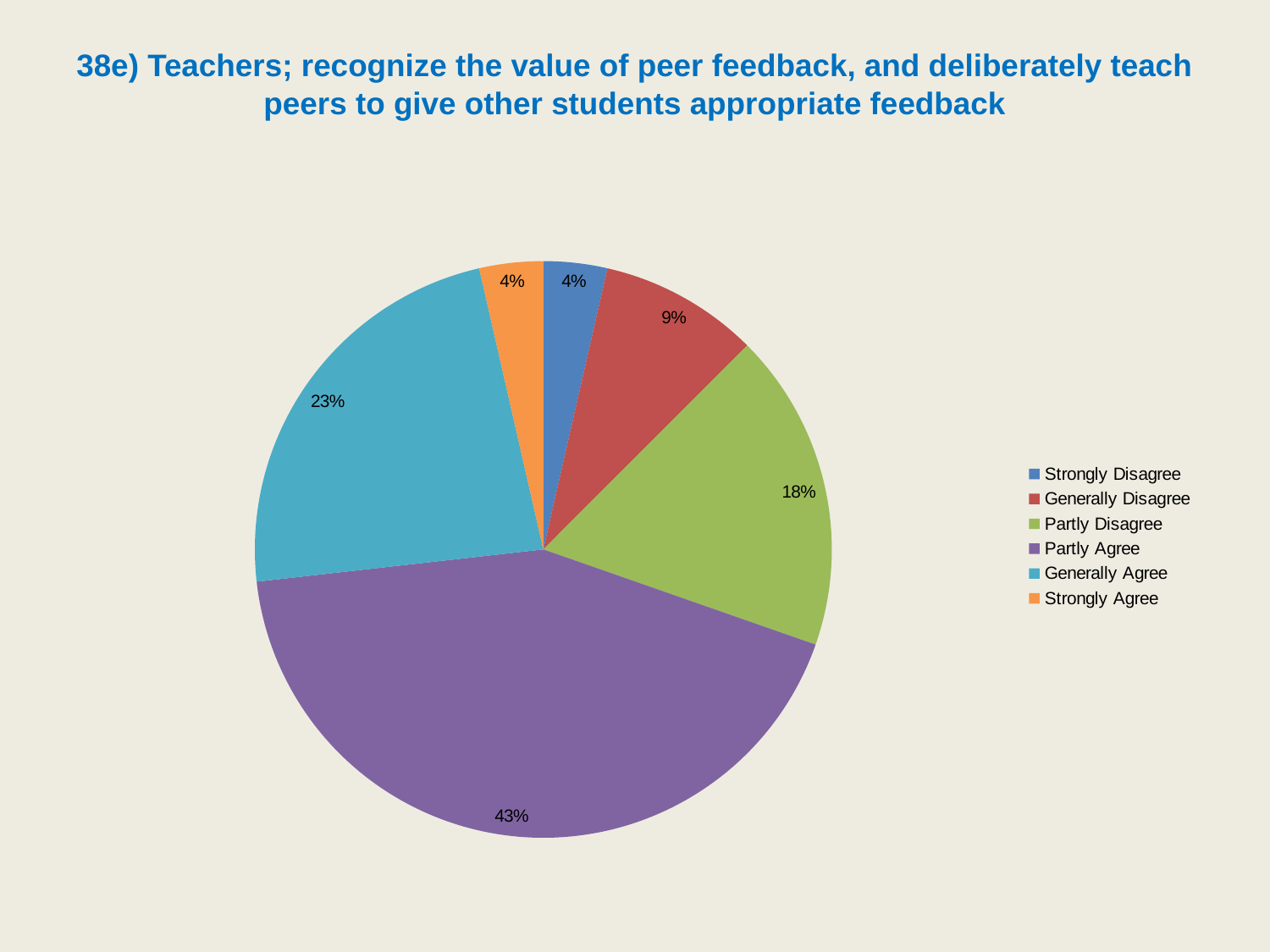
What percentage of respondents chose Partly Disagree? 18% How many response categories does the legend list? 6 Which response category has the largest share of the pie? Partly Agree What kind of chart is shown on the slide? pie chart Which is larger, the share for Partly Disagree or the share for Generally Disagree? Partly Disagree What percentage of respondents chose Generally Disagree? 9% What percentage of respondents chose Partly Agree? 43% What percentage of respondents chose Generally Agree? 23% What percentage of respondents chose Strongly Agree? 4% What is the combined share of Generally Agree and Strongly Agree? 27% What is the difference in percentage points between Partly Agree and Generally Agree? 20 What colour is the Partly Agree slice? purple